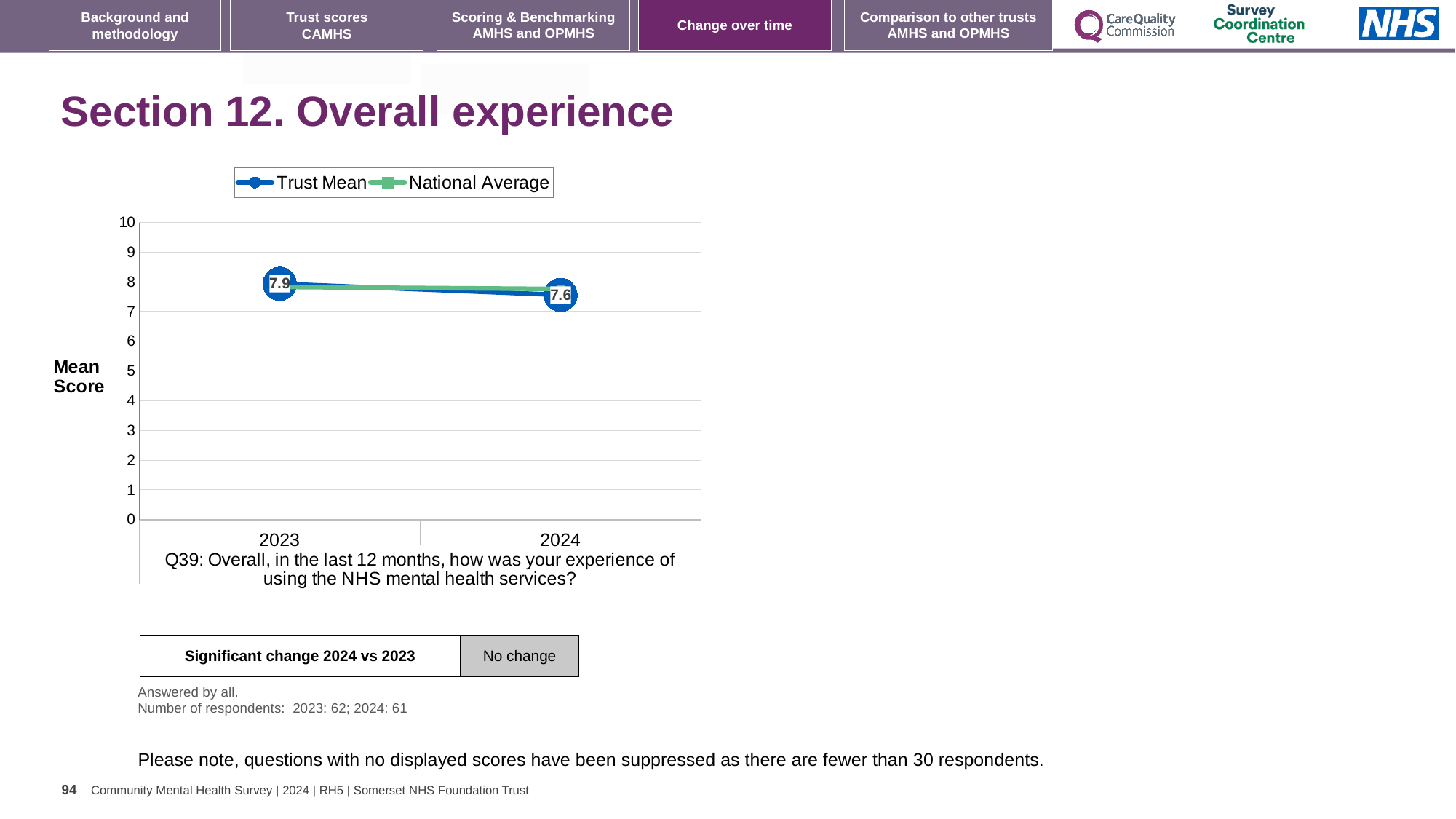
Does the Trust Mean rise or fall from 2023 to 2024? Fall In which year is the Trust Mean lowest? 2024 What is the Trust Mean value for 2023? 7.9 What is the label on the y axis of the chart? Mean Score Which is larger, the Trust Mean for 2023 or for 2024? 2023 In which year is the Trust Mean highest? 2023 How many series does the legend list? 2 What kind of chart is shown on the slide? Line chart What is the Trust Mean value for 2024? 7.6 Is the National Average value for 2024 greater or less than 5? greater How many years are shown on the x axis of the chart? 2 What is the difference between the Trust Mean in 2023 and in 2024? 0.3